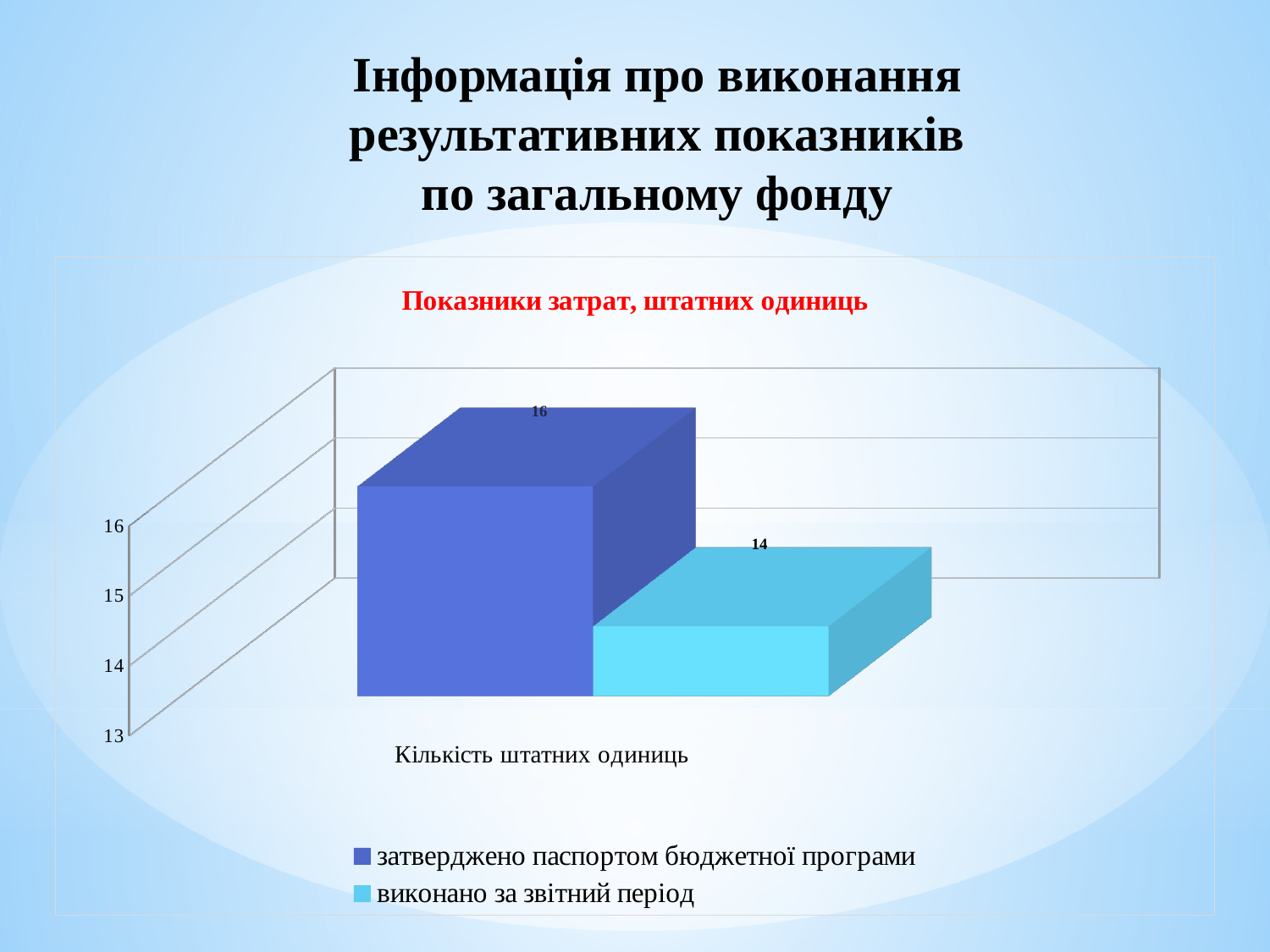
Is the value for 'виконано за звітний період' larger or smaller than the value for 'затверджено паспортом бюджетної програми'? smaller What is the category label shown on the x axis of the chart? Кількість штатних одиниць Which series has the higher value in the chart? затверджено паспортом бюджетної програми What kind of chart is shown on the slide? bar chart Which series has the lower value in the chart? виконано за звітний період What is the difference between the value for 'затверджено паспортом бюджетної програми' and the value for 'виконано за звітний період'? 2 What is the value for 'затверджено паспортом бюджетної програми' in the chart? 16 How many series does the legend list? 2 What is the title of the chart? Показники затрат, штатних одиниць How many categories are shown on the x axis of the chart? 1 Is the value for 'виконано за звітний період' greater or less than 15? less What is the value for 'виконано за звітний період' in the chart? 14